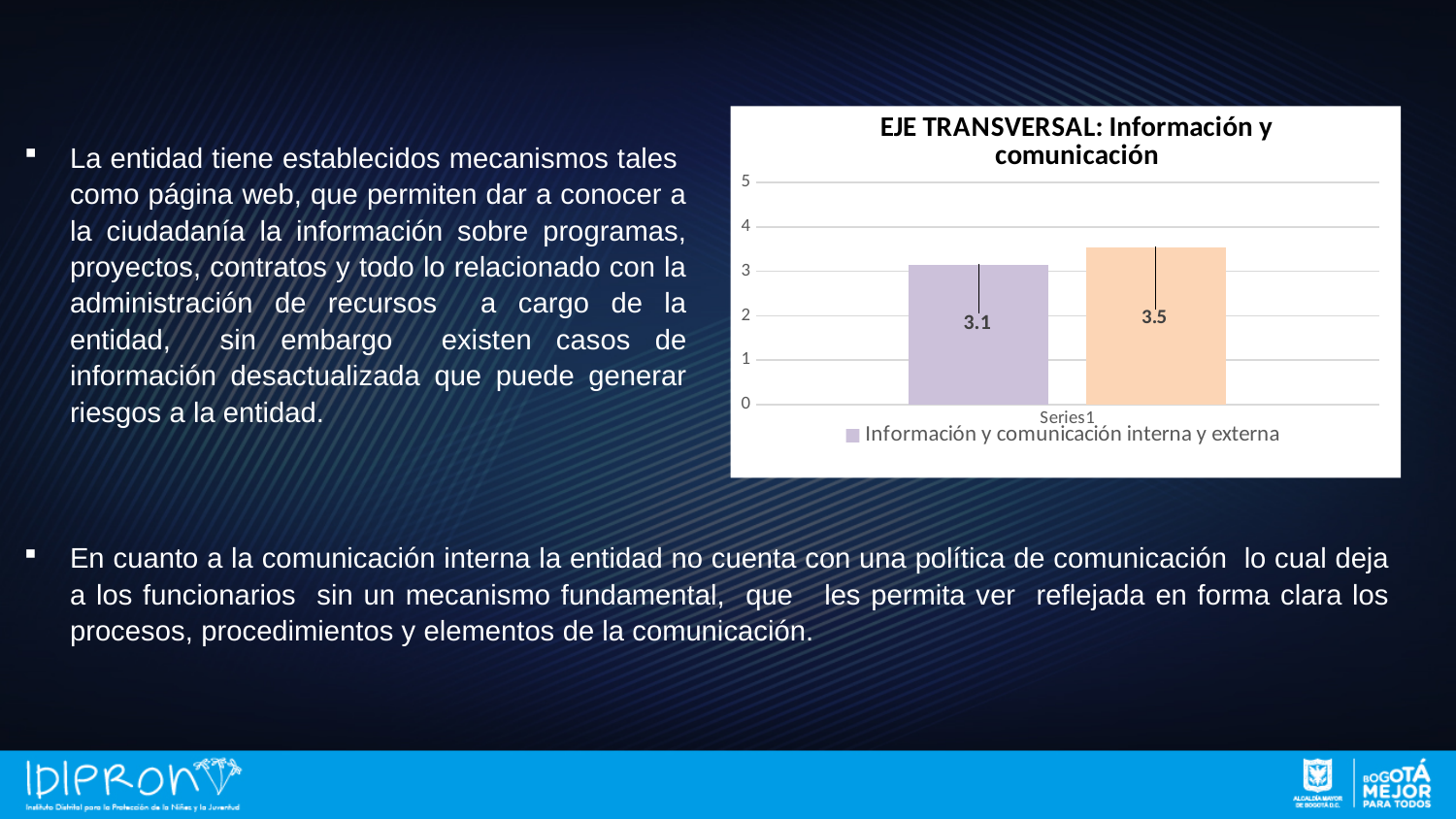
What entry does the chart legend show? Información y comunicación interna y externa Which bar has the higher value, the purple one or the orange one? the orange one What is the value shown on the orange (right) bar? 3.5 Is the value of the purple bar greater or less than 4? less How many bars are plotted in the chart? 2 Is the value of the orange bar greater or less than 3? greater What type of chart is shown on the slide? bar chart What is the difference between the values of the orange bar and the purple bar? 0.4 What is the title of the chart? EJE TRANSVERSAL: Información y comunicación What is the highest value shown on the vertical axis of the chart? 5 Which bar has the lower value, the purple one or the orange one? the purple one What is the value shown on the purple (left) bar? 3.1